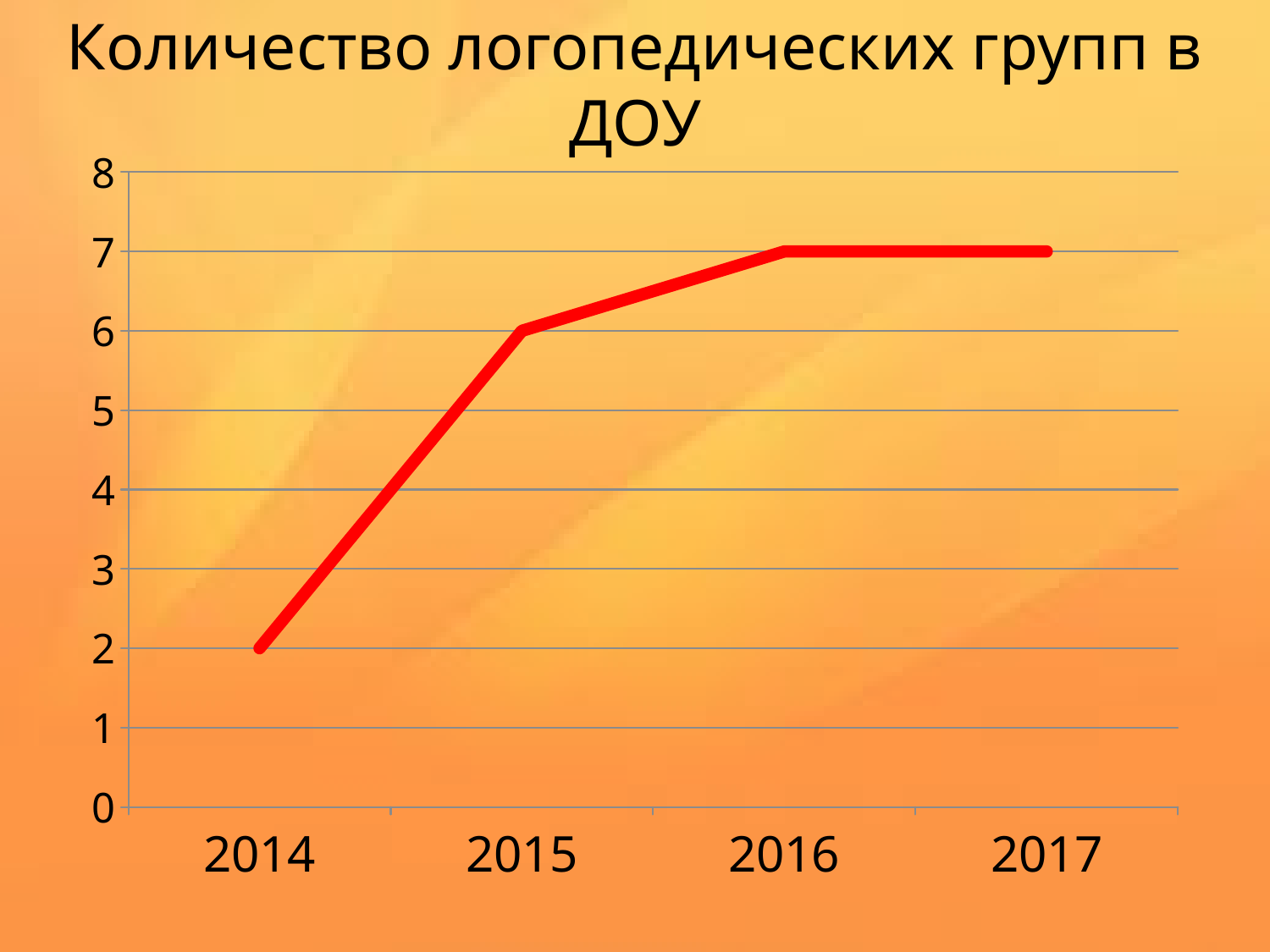
Which year has the lowest value? 2014 How many years are shown on the x axis? 4 Which is larger, the value for 2015 or the value for 2014? 2015 What is the value for 2015? 6 What is the difference between the values for 2015 and 2014? 4 What is the value for 2014? 2 What is the value for 2017? 7 What is the difference between the values for 2016 and 2015? 1 Do the values rise or fall from 2014 to 2016? rise What is the value for 2016? 7 Is the value for 2014 greater or less than 3? less What kind of chart is shown on the slide? line chart